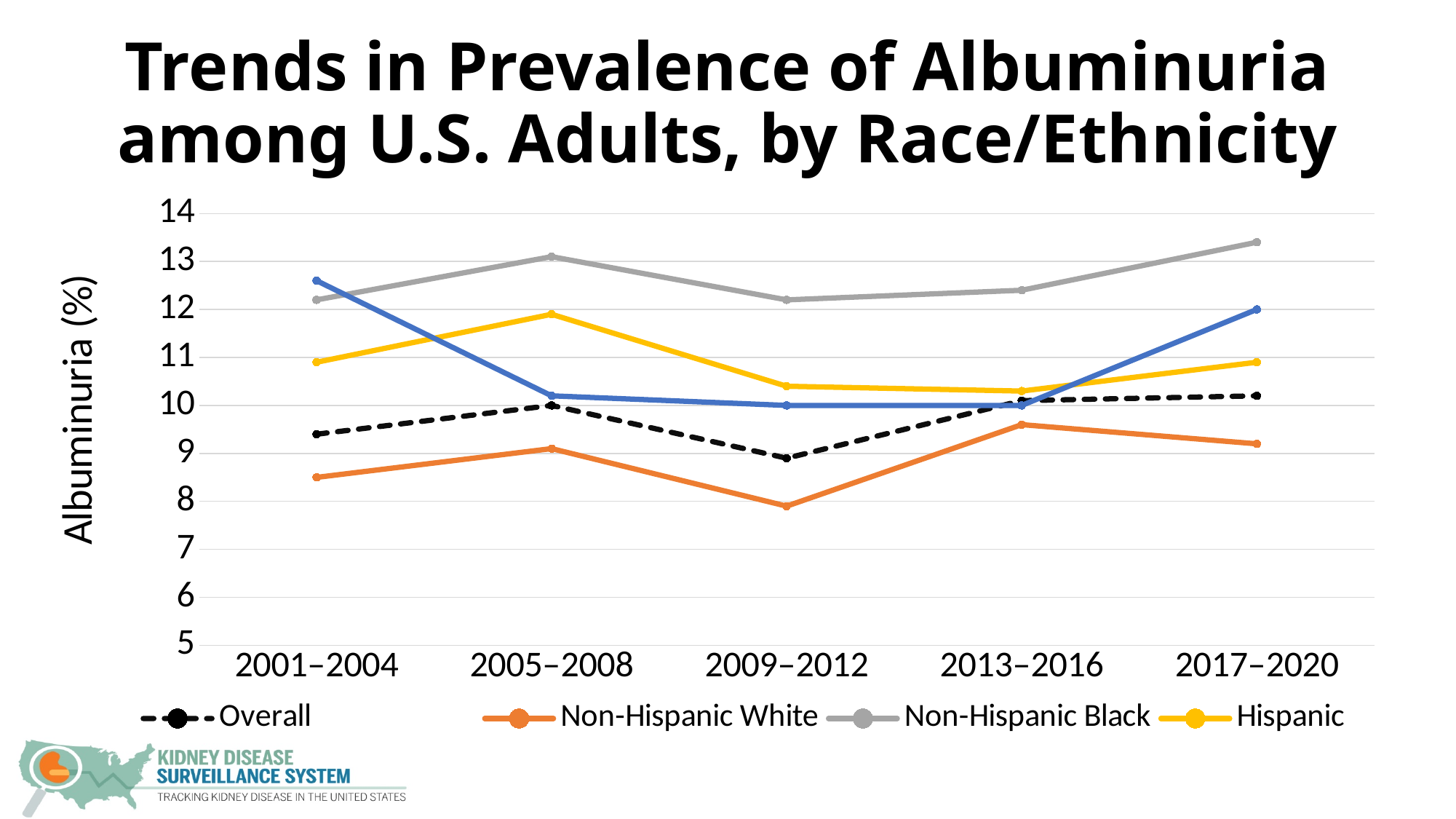
How many time periods are shown on the x axis? 5 What is the label on the y axis? Albuminuria (%) In 2005–2008, which is larger: the Hispanic value or the Non-Hispanic White value? Hispanic How many series does the legend list? 4 Which series has the highest value in 2017–2020? Non-Hispanic Black In which period is the Non-Hispanic Black value highest? 2017–2020 Is the Non-Hispanic White value for 2001–2004 greater or less than 9? less In which period is the Non-Hispanic White value lowest? 2009–2012 Which series has the lowest value in 2009–2012? Non-Hispanic White What kind of chart is shown on the slide? line chart Is the Non-Hispanic Black value for 2017–2020 greater or less than 13? greater Does the Non-Hispanic Black line rise or fall from 2009–2012 to 2017–2020? rise